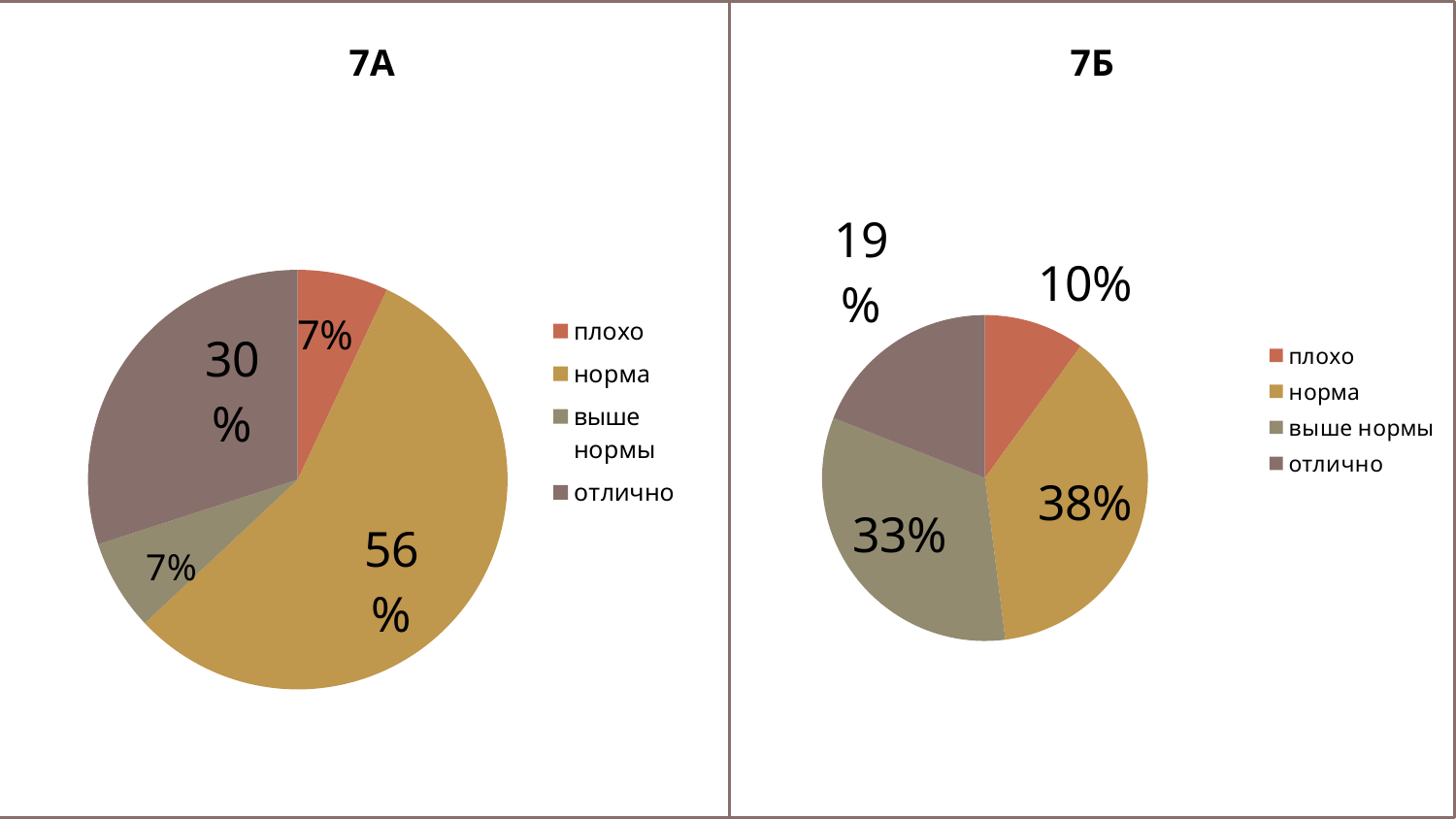
In the 7А chart, which category has the largest slice? норма In the 7Б chart, which category has the largest slice? норма How many categories does the legend of the 7Б chart list? 4 In the 7Б chart, what is the difference between the норма and отлично shares? 19% In the 7Б chart, which category has the smallest slice? плохо In the 7А chart, what share is labelled for отлично? 30% In the 7А chart, what share is labelled for норма? 56% In the 7А chart, what is the difference between the норма and отлично shares? 26% Which chart has the larger share for отлично, 7А or 7Б? 7А What type of chart is used on this slide? Pie chart In the 7Б chart, what share is labelled for выше нормы? 33% In the 7Б chart, what share is labelled for плохо? 10%